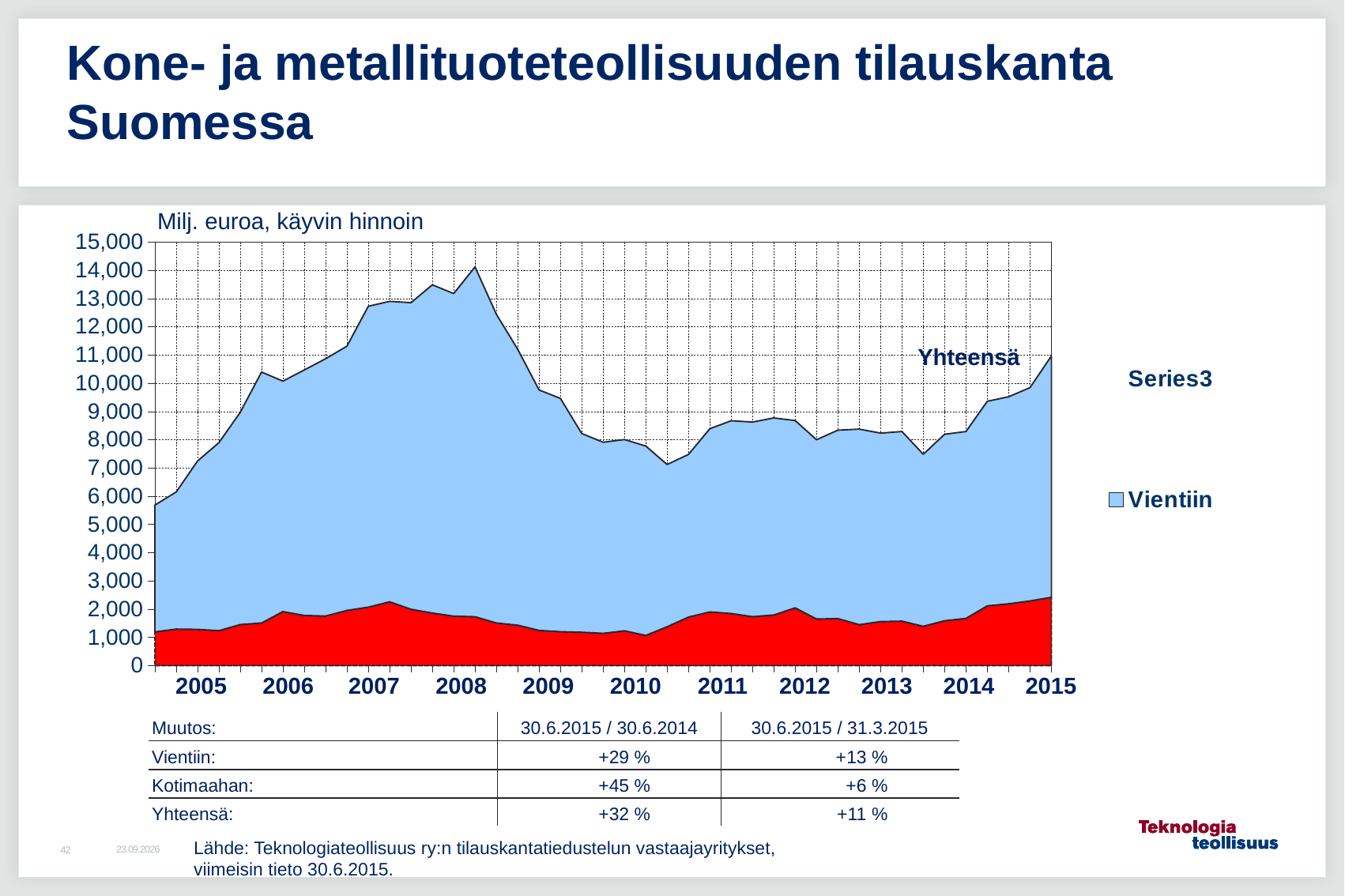
Is the peak total value around 2008 greater or less than 13,000? greater In which year does the total (Yhteensä) order book reach its highest point? 2008 What unit label is shown above the chart's y axis? Milj. euroa, käyvin hinnoin Does the total (Yhteensä) value rise or fall between 2013 and 2015? rise Is the total (Yhteensä) value at 2015 greater or less than 10,000? greater Is the total (Yhteensä) value at 2013 greater or less than 9,000? less How many entries does the chart legend list? 2 What kind of chart is shown on the slide? area chart How many year labels are shown on the x axis of the chart? 11 Does the total (Yhteensä) value rise or fall between 2008 and 2009? fall